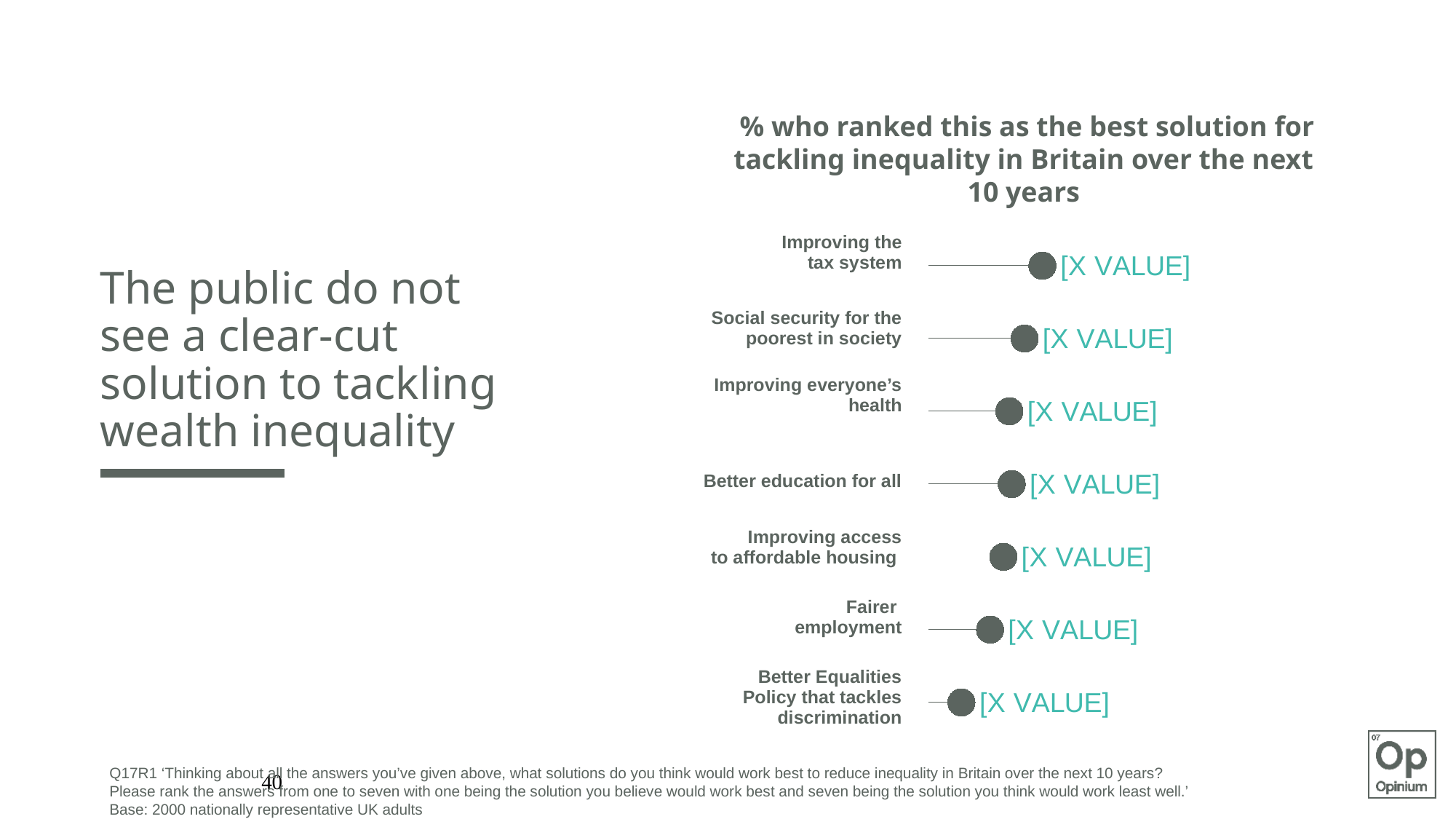
What is the title of the chart? % who ranked this as the best solution for tackling inequality in Britain over the next 10 years How many solutions (categories) are shown in the chart? 7 Which is larger: the value for Social security for the poorest in society or the value for Fairer employment? Social security for the poorest in society Which solution is listed first (at the top) of the chart? Improving the tax system Which solution has the lowest share of people ranking it as the best solution? Better Equalities Policy that tackles discrimination Which solution has the highest share of people ranking it as the best solution? Improving the tax system Which is larger: the value for Improving the tax system or the value for Better Equalities Policy that tackles discrimination? Improving the tax system